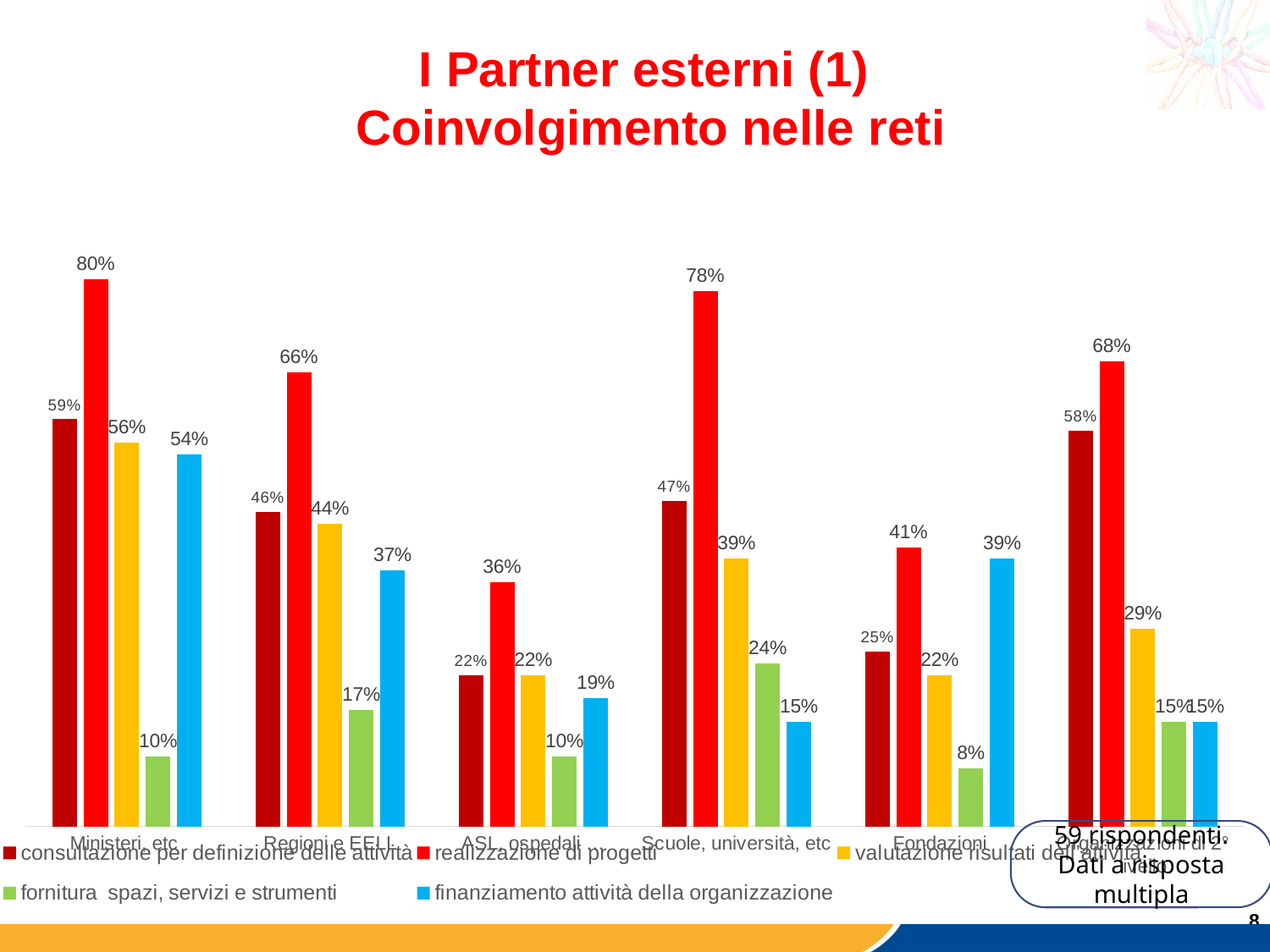
What is the value of 'valutazione risultati dell'attività' for Scuole, università, etc? 39% What kind of chart is shown on the slide? bar chart How many category groups are plotted on the chart? 6 What is the difference between 'realizzazione di progetti' and 'consultazione per definizione delle attività' for Scuole, università, etc? 31% What is the value of 'realizzazione di progetti' for Ministeri, etc? 80% What is the value of 'finanziamento attività della organizzazione' for Regioni e EELL? 37% Which is larger for Fondazioni: 'realizzazione di progetti' or 'finanziamento attività della organizzazione'? realizzazione di progetti Which category has the highest value for 'realizzazione di progetti'? Ministeri, etc What is the value of 'fornitura spazi, servizi e strumenti' for Fondazioni? 8% How many series does the legend list? 5 What colour represents 'finanziamento attività della organizzazione' in the chart? blue Which category has the lowest value for 'consultazione per definizione delle attività'? ASL, ospedali